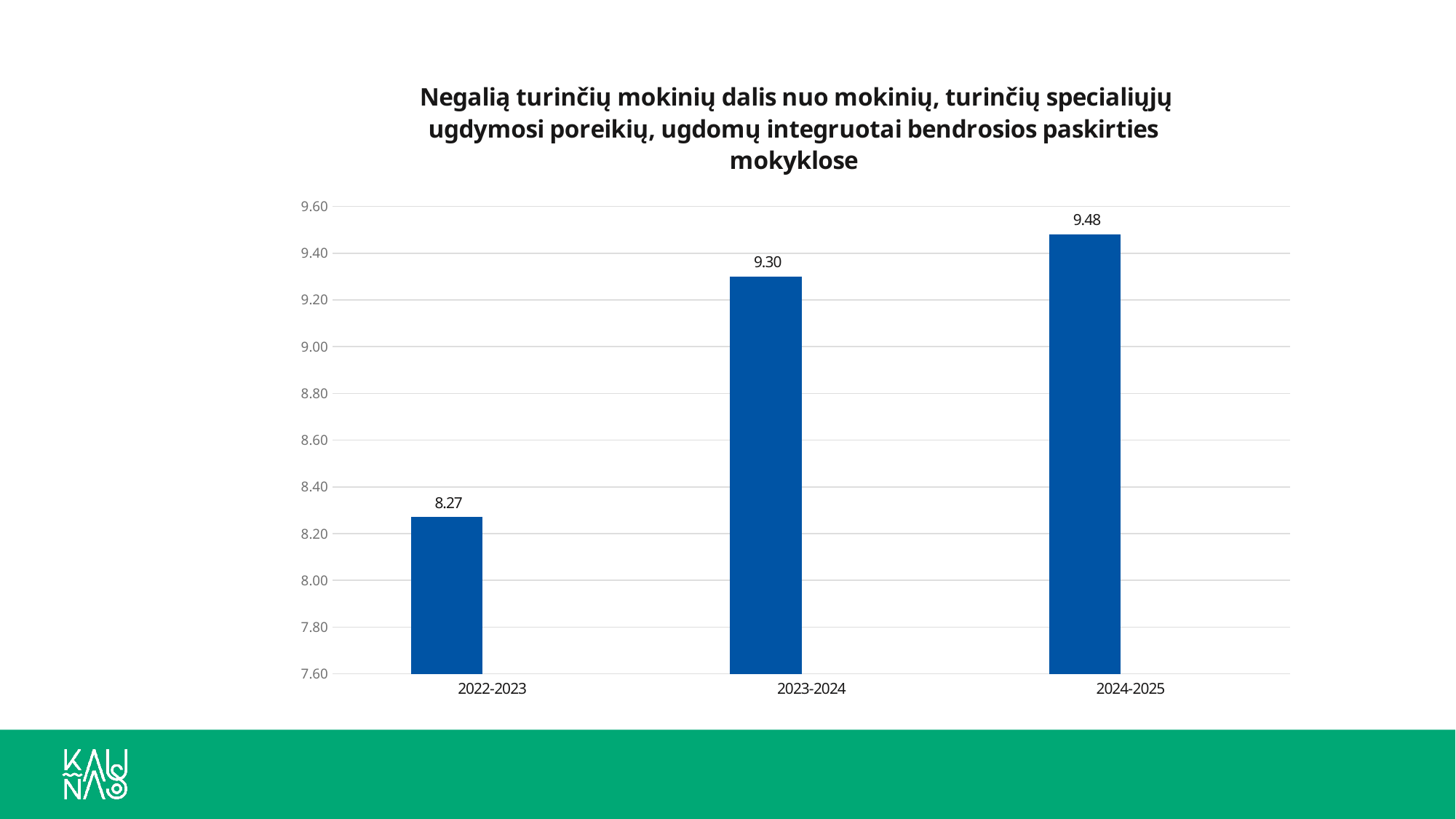
Is the value for 2022-2023 greater or less than 8.40? less What kind of chart is shown on the slide? bar chart What is the difference between the values for 2023-2024 and 2022-2023? 1.03 What is the value for 2023-2024? 9.30 Which school year has the lowest value? 2022-2023 How many school years are shown on the chart? 3 Do the values rise or fall from 2022-2023 to 2024-2025? rise Which is larger, the value for 2023-2024 or the value for 2024-2025? 2024-2025 What is the difference between the values for 2024-2025 and 2022-2023? 1.21 Which school year has the highest value? 2024-2025 What is the value for 2022-2023? 8.27 What is the value for 2024-2025? 9.48